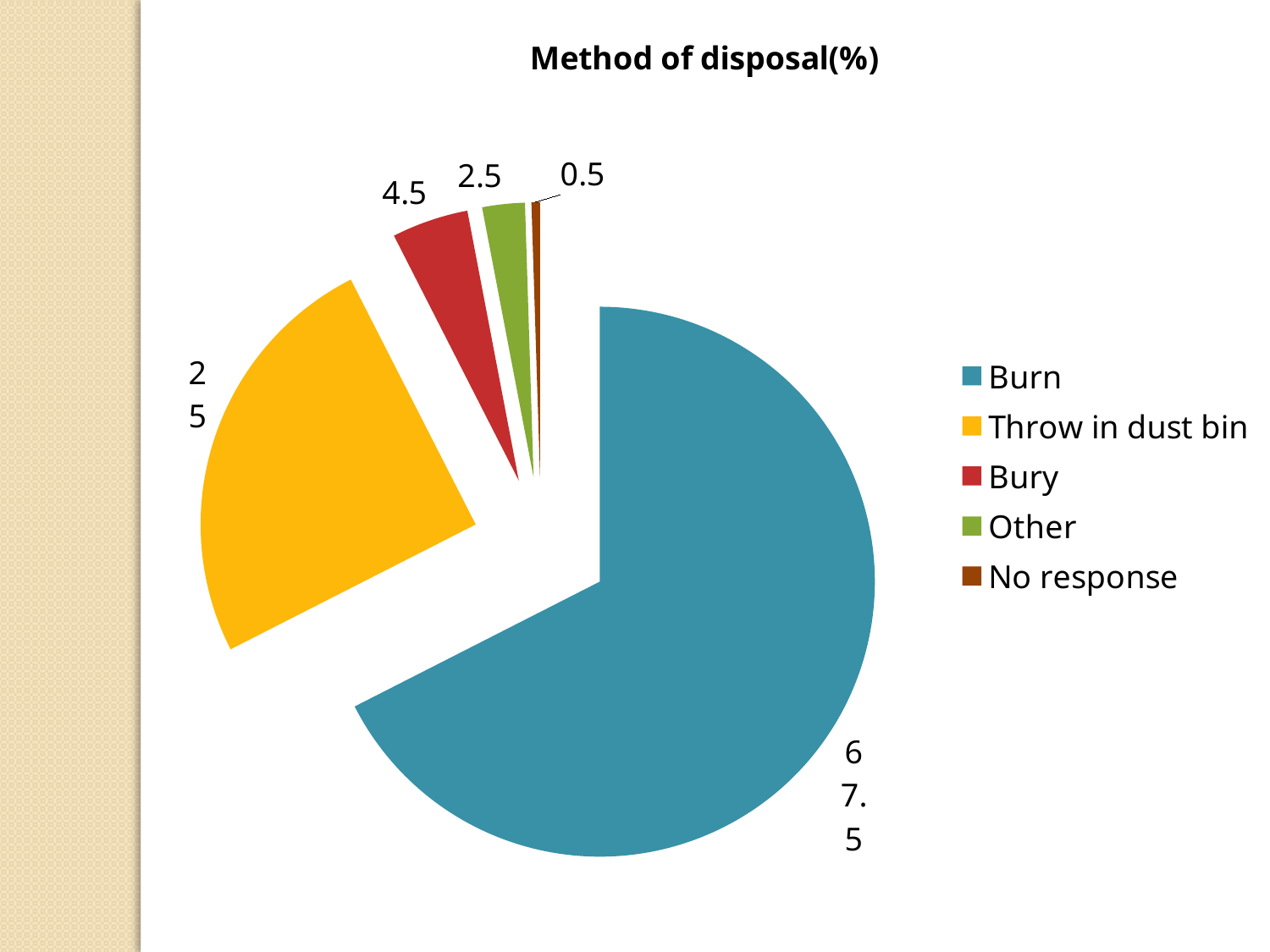
Which method of disposal has the largest share? Burn What is the value for Throw in dust bin? 25 What is the value for Other? 2.5 Which method of disposal has the smallest share? No response What is the value for Bury? 4.5 What is the value for Burn? 67.5 What is the value for No response? 0.5 How many categories does the legend list? 5 What is the difference between the values for Burn and Throw in dust bin? 42.5 Which is larger, the value for Bury or the value for Other? Bury What is the title of the chart? Method of disposal(%) What kind of chart is shown on the slide? Pie chart